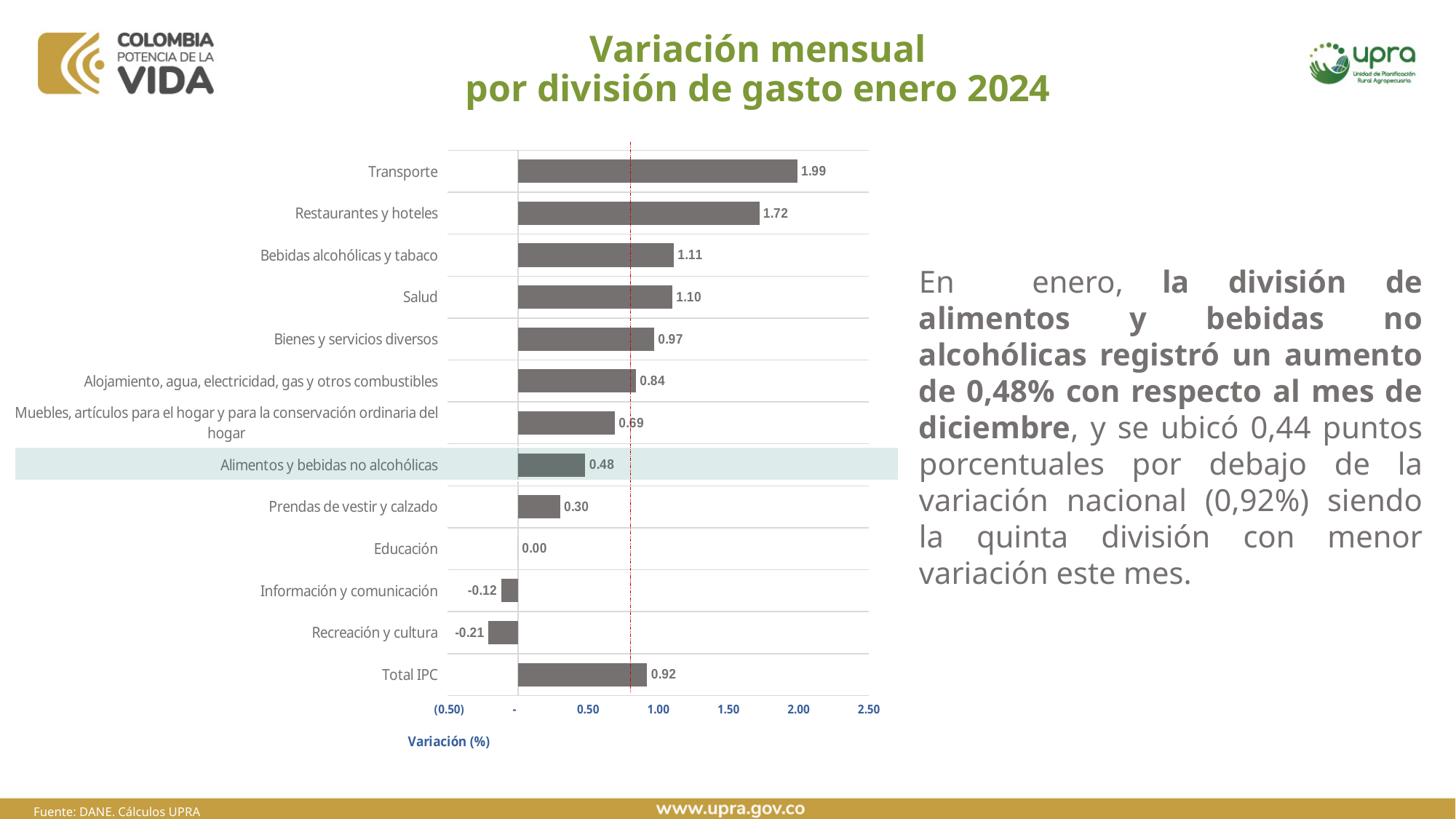
What is the value for Total IPC? 0.92 What is the label of the horizontal axis? Variación (%) Which is larger, the value for Salud or the value for Bienes y servicios diversos? Salud How many categories are shown on the chart? 13 What is the value for Alimentos y bebidas no alcohólicas? 0.48 What is the difference between the values for Transporte and Restaurantes y hoteles? 0.27 What is the value for Transporte? 1.99 What is the value for Educación? 0.00 What kind of chart is shown on the slide? Bar chart Which category has the lowest value? Recreación y cultura Which category has the highest value? Transporte What is the title of the chart? Variación mensual por división de gasto enero 2024